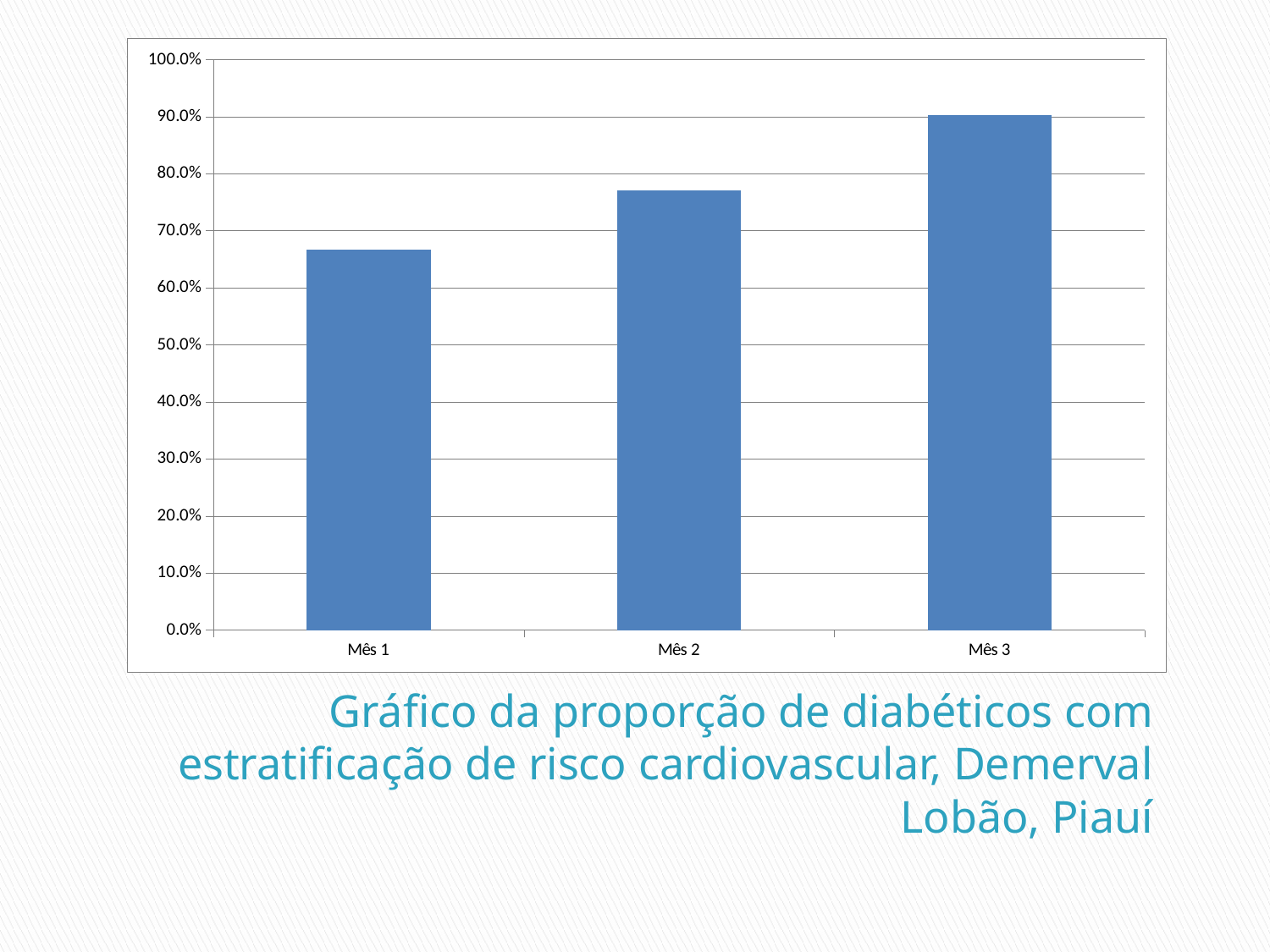
Is the value for Mês 2 greater or less than 80.0%? less Do the values rise or fall from Mês 1 to Mês 3? rise Is the value for Mês 2 greater or less than 70.0%? greater How many categories are shown on the x axis of the chart? 3 What kind of chart is shown on the slide? bar chart Is the value for Mês 1 greater or less than 60.0%? greater Which month has the highest value in the chart? Mês 3 What is the maximum value shown on the vertical axis of the chart? 100.0% Which month has the lowest value in the chart? Mês 1 Which is larger, the value for Mês 2 or the value for Mês 3? Mês 3